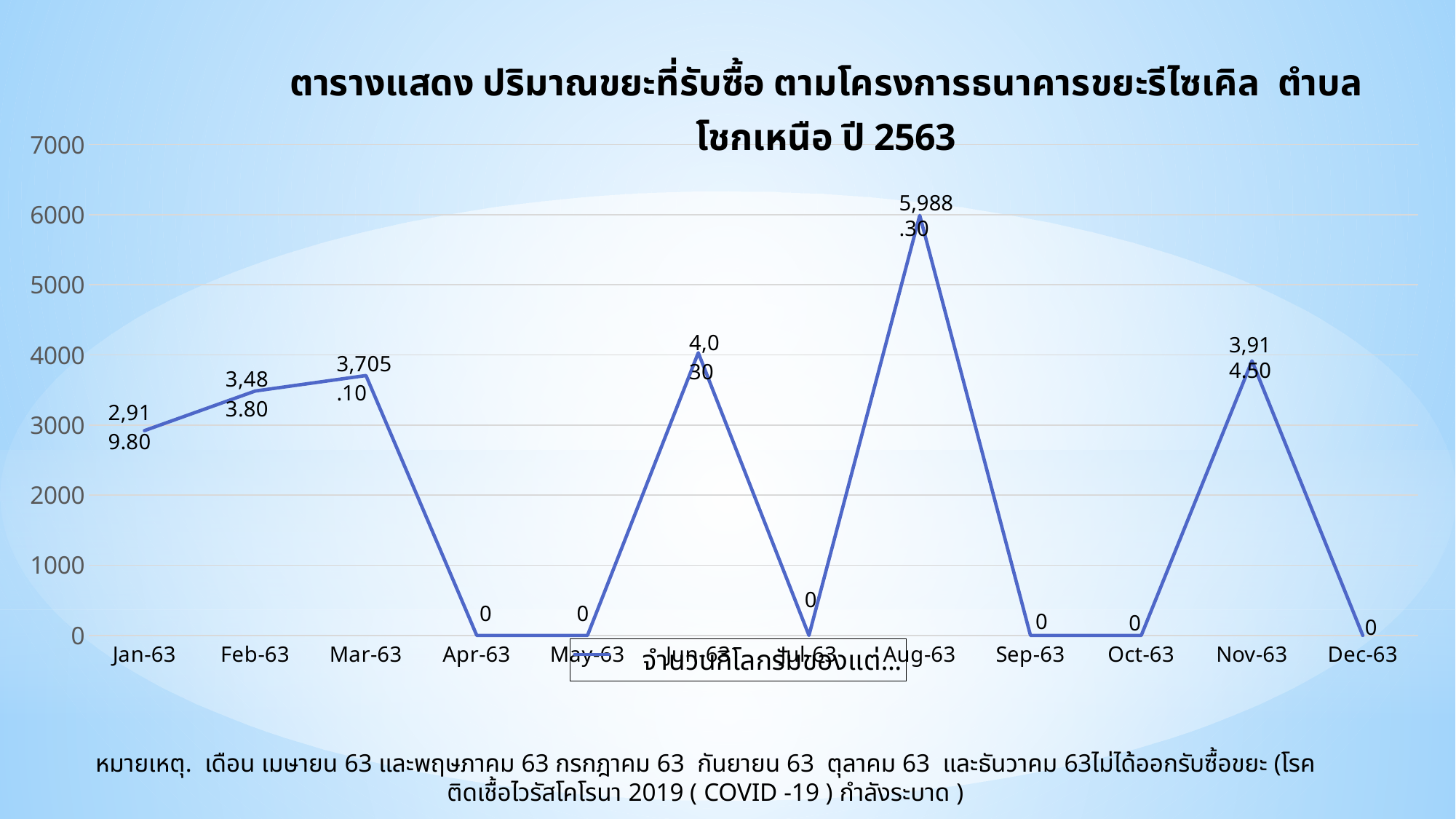
What is the value for Aug-63? 5,988.30 Do the values rise or fall from Jan-63 to Mar-63? rise What is the difference between the values for Aug-63 and Mar-63? 2,283.20 Which month has the highest value? Aug-63 What is the value for Apr-63? 0 How many months are plotted along the x axis? 12 What is the value for Nov-63? 3,914.50 What is the value for Mar-63? 3,705.10 What kind of chart is shown on the slide? line chart Which is larger, the value for Feb-63 or the value for Mar-63? Mar-63 Is the value for Jan-63 greater or less than 3000? less How many months have a value of 0? 6